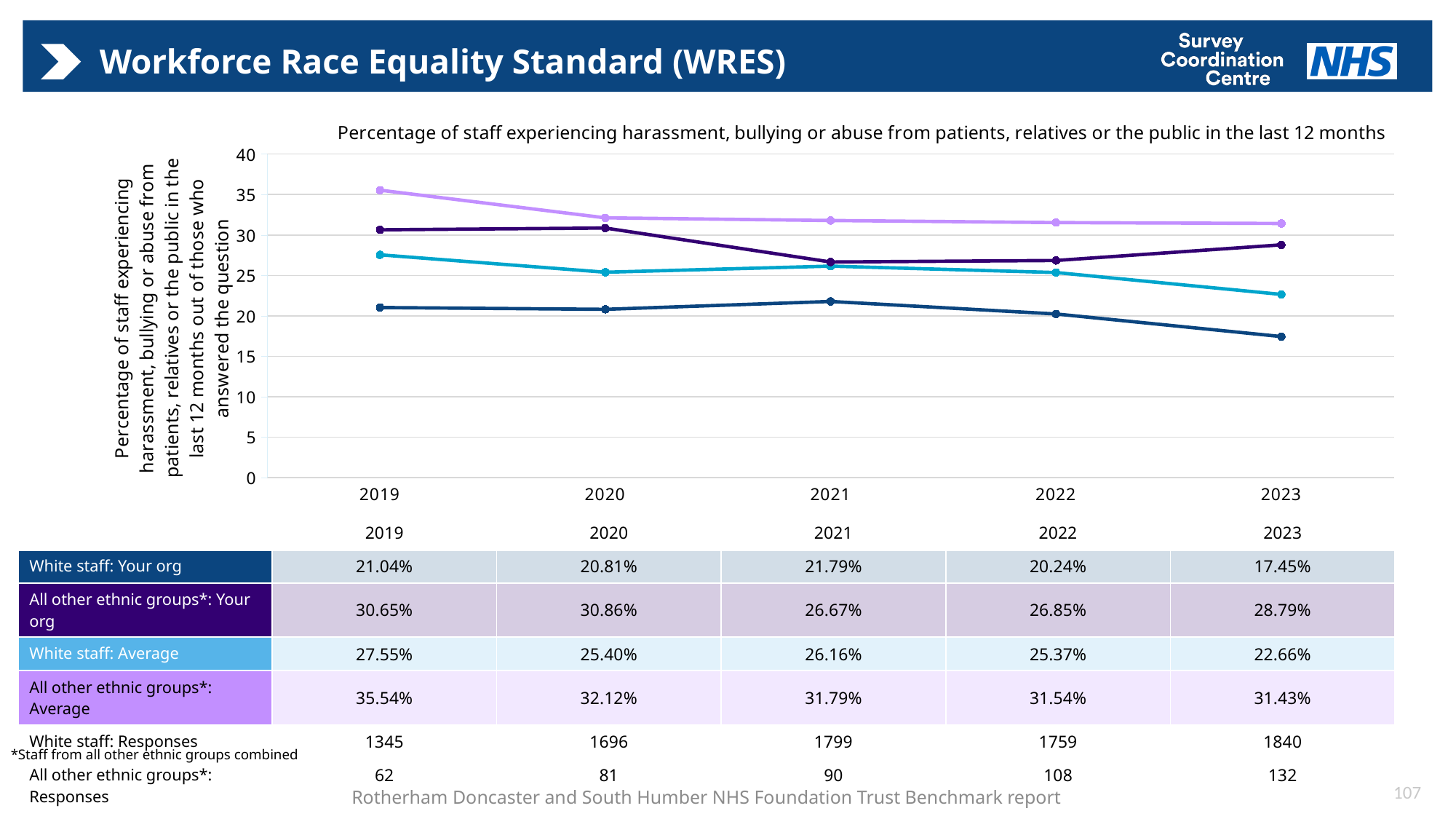
How many years are shown on the x axis of the chart? 5 In which year is the value for White staff: Your org lowest? 2023 What is the difference between All other ethnic groups*: Your org and White staff: Your org in 2023? 11.34 percentage points What is the value for All other ethnic groups*: Average in 2019? 35.54% Does the value for White staff: Average rise or fall from 2019 to 2023? fall How many series are plotted on the chart? 4 In which year is the value for All other ethnic groups*: Your org highest? 2020 Is the value for All other ethnic groups*: Average in 2019 greater or less than 35? greater What is the value for White staff: Average in 2021? 26.16% What kind of chart is shown on the slide? line chart What is the value for White staff: Your org in 2023? 17.45% Which is larger in 2021: White staff: Average or White staff: Your org? White staff: Average